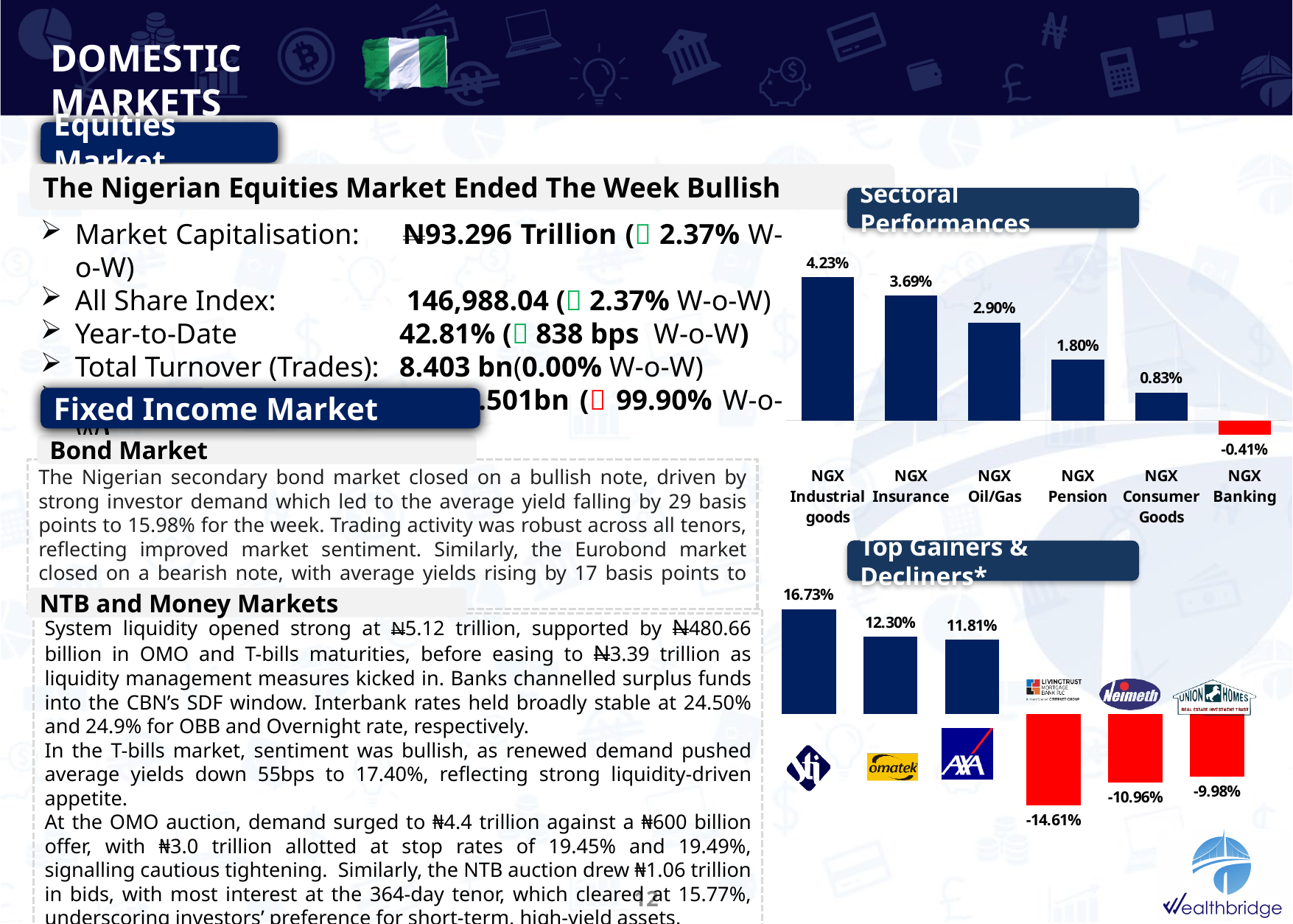
On the Sectoral Performances chart, which sector has the lowest value? NGX Banking What kind of chart is the Sectoral Performances chart? Bar chart How many sectors are shown on the Sectoral Performances chart? 6 On the Sectoral Performances chart, do the values rise or fall from left to right? Fall On the Sectoral Performances chart, what is the difference between NGX Insurance and NGX Oil/Gas? 0.79% On the Sectoral Performances chart, what is the value for NGX Banking? -0.41% On the Sectoral Performances chart, which is larger, NGX Consumer Goods or NGX Pension? NGX Pension On the Top Gainers & Decliners chart, what is the lowest value shown? -14.61% On the Sectoral Performances chart, what is the value for NGX Pension? 1.80% On the Sectoral Performances chart, which sector has the highest value? NGX Industrial goods On the Top Gainers & Decliners chart, what is the highest value shown? 16.73% On the Sectoral Performances chart, what is the value for NGX Industrial goods? 4.23%